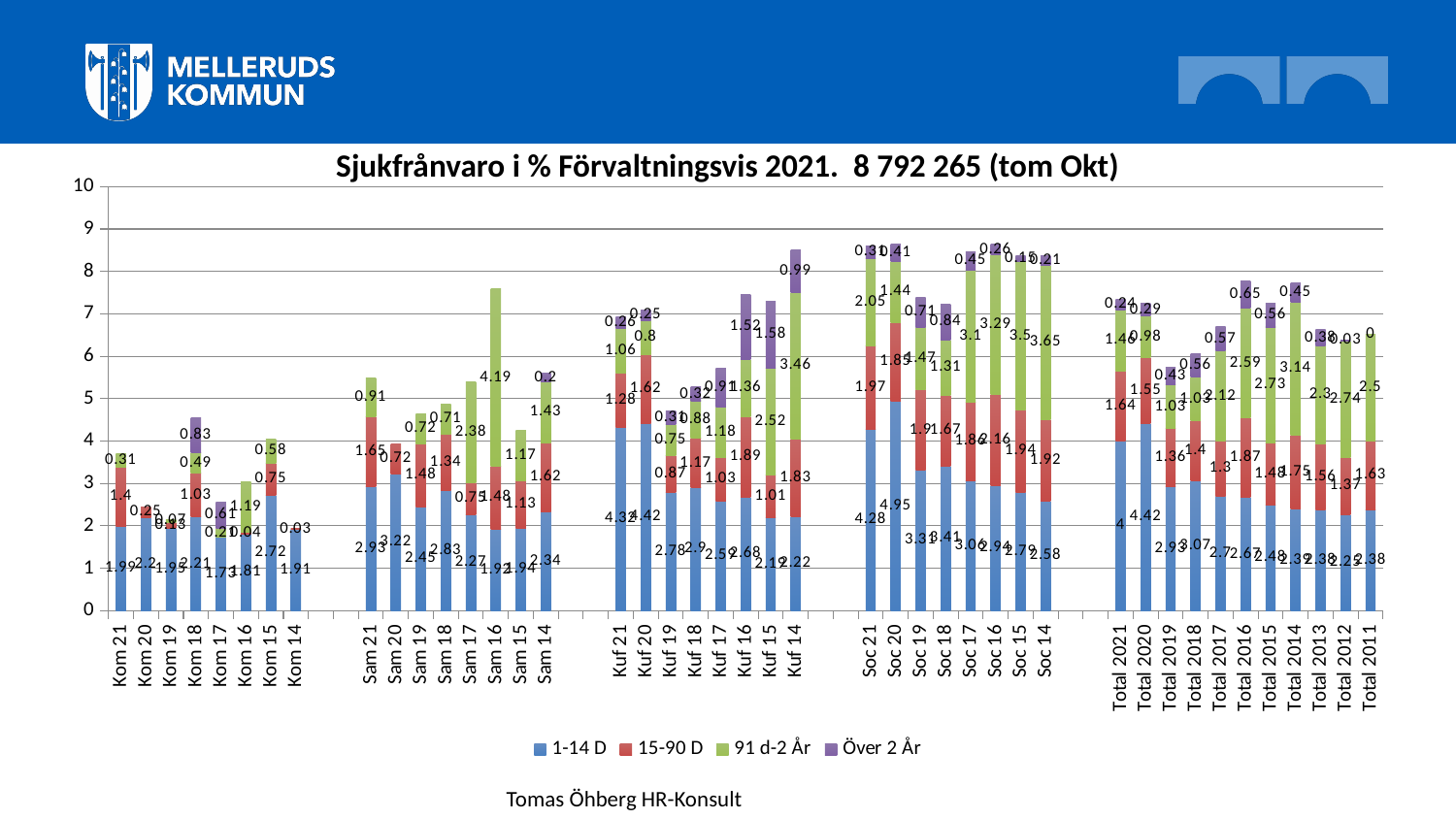
How many series does the legend list? 4 What is the 1-14 D value for Soc 20? 4.95 What is the 91 d-2 År value for Sam 16? 4.19 What is the title of the chart? Sjukfrånvaro i % Förvaltningsvis 2021. 8 792 265 (tom Okt) What is the Över 2 År value for Kuf 14? 0.99 Which has the larger 1-14 D value, Kuf 21 or Total 2021? Kuf 21 What is the 15-90 D value for Total 2021? 1.64 Is the total stacked value for Sam 16 greater or less than 7? greater What is the total of the stacked bar for Kuf 14? 8.5 What is the difference between the 1-14 D values for Soc 20 and Soc 21? 0.67 What type of chart is shown on the slide? Stacked bar chart Which category has the lowest total stacked bar? Kom 14